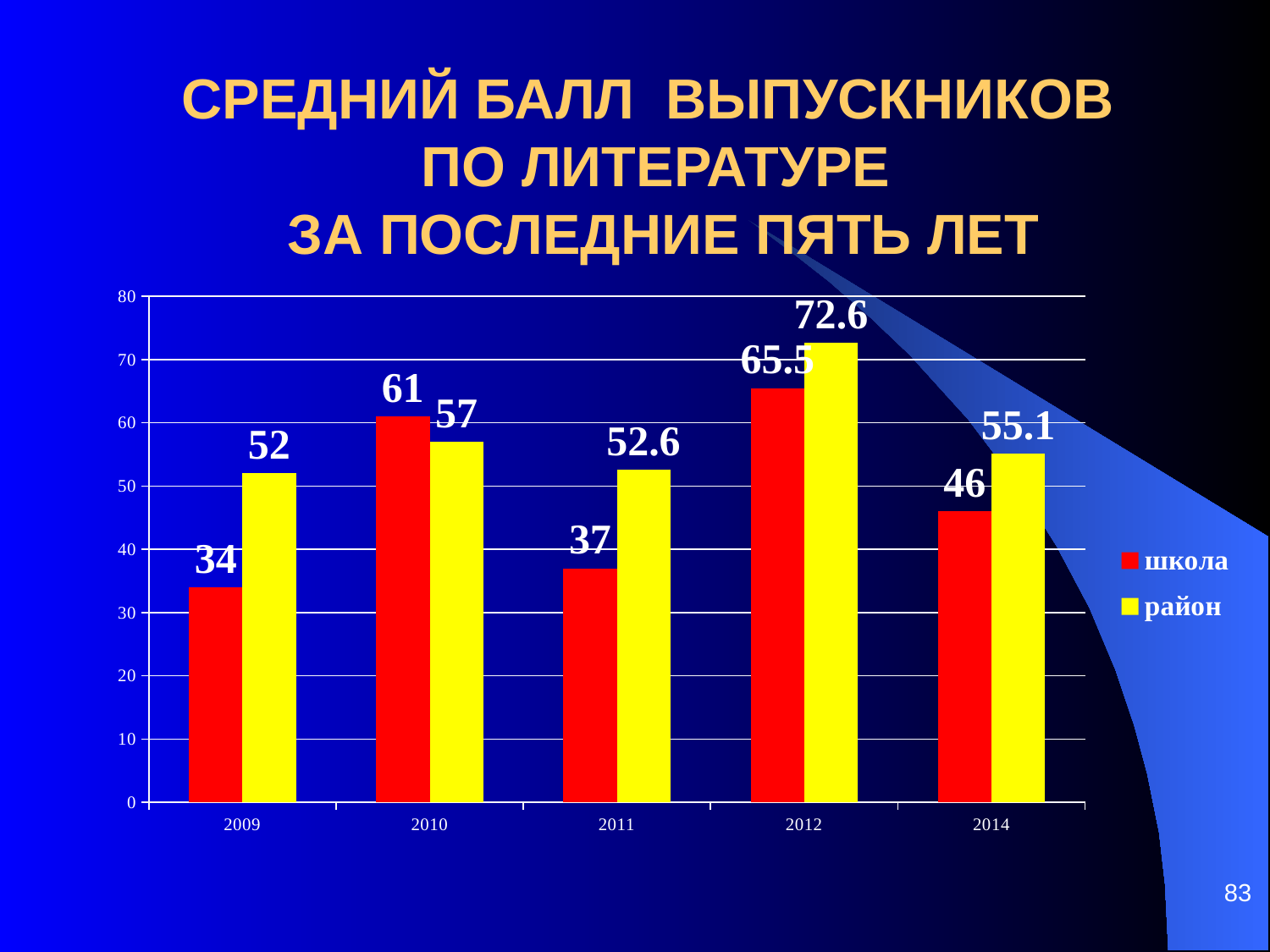
What kind of chart is shown on the slide? bar chart How many years are shown on the x axis? 5 What colour are the bars for район? yellow What is the difference between район and школа in 2011? 15.6 Is the value for район in 2014 greater or less than 50? greater What is the value for район in 2012? 72.6 Which year has the highest value for школа? 2012 What is the value for школа in 2009? 34 How many series does the legend list? 2 Which year has the lowest value for район? 2009 What is the value for школа in 2014? 46 Which is larger in 2010, школа or район? школа